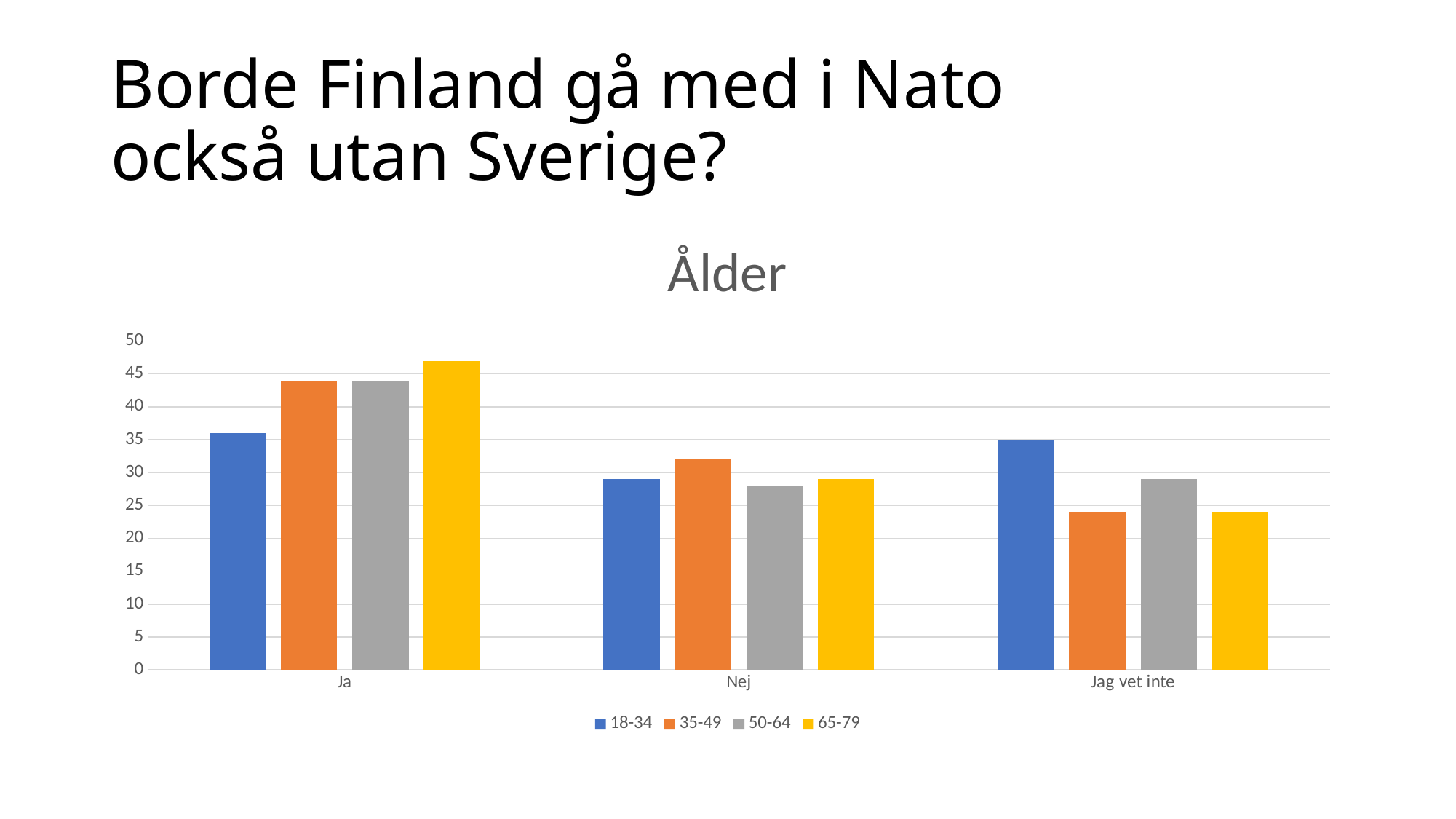
Is the value for 18-34 in the Jag vet inte category greater or less than 30? greater Is the value for 18-34 in the Ja category greater or less than 40? less Which is larger: the 35-49 value for Ja or the 35-49 value for Nej? Ja How many answer categories are shown on the x axis? 3 Which age group has the highest bar in the Nej category? 35-49 How many series does the legend list? 4 Which age group has the lowest bar in the Ja category? 18-34 Which age group has the highest bar in the Ja category? 65-79 Is the value for 65-79 in the Ja category greater or less than 45? greater What kind of chart is shown on the slide? bar chart What is the title of the chart? Ålder Which age group has the highest bar in the Jag vet inte category? 18-34